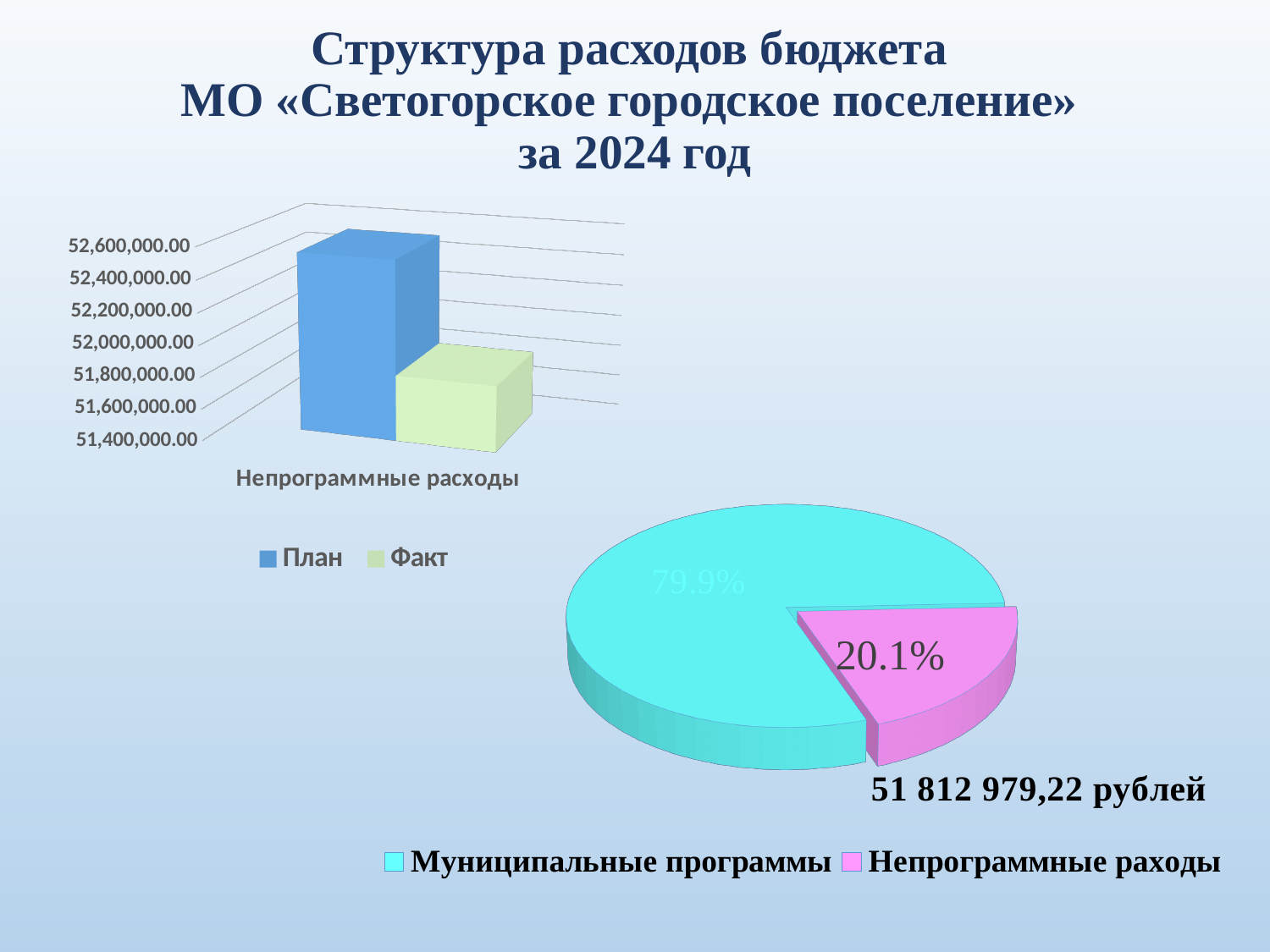
In the bar chart, which series has the taller bar for Непрограммные расходы, План or Факт? План In the pie chart, which slice is the largest? Муниципальные программы In the bar chart, how many series does the legend list? 2 In the pie chart, which slice is the smallest? Непрограммные раходы What kind of chart is the chart at the top left of the slide? Bar chart In the pie chart, what is the difference in percentage points between the Муниципальные программы slice and the Непрограммные раходы slice? 59.8 In the pie chart, how many slices are there? 2 In the pie chart, what share do Непрограммные раходы have? 20.1% In the bar chart, is the value for Факт greater or less than 52,000,000.00? less What kind of chart is the chart at the bottom right of the slide? Pie chart In the pie chart, what share do Муниципальные программы have? 79.9% In the bar chart, is the value for План greater or less than 52,000,000.00? greater